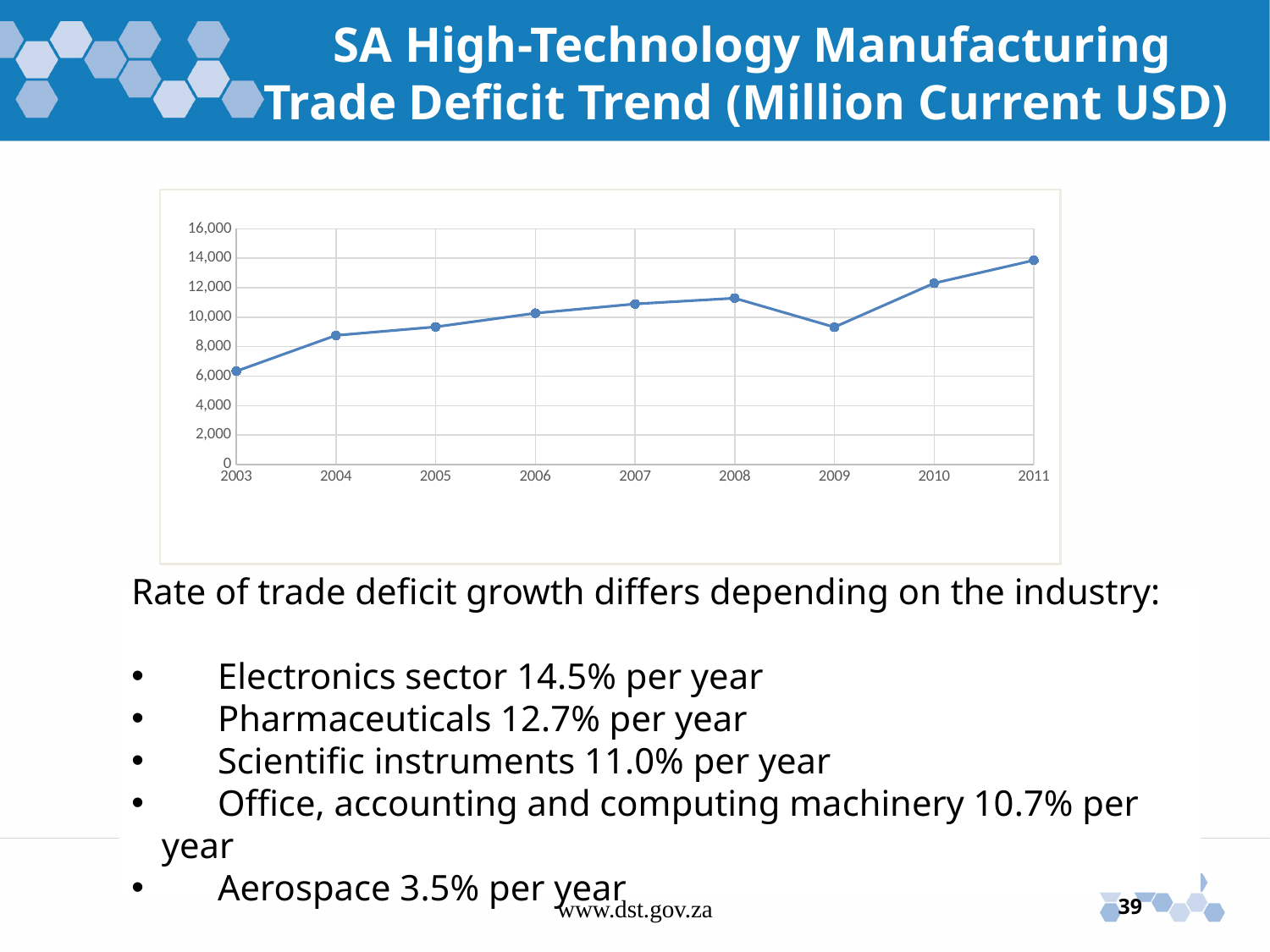
Is the value for 2011 greater or less than 12,000? greater Which year has the larger value, 2008 or 2009? 2008 How many years are plotted on the x axis of the chart? 9 Is the value for 2010 greater or less than 10,000? greater Which year has the highest trade deficit value in the chart? 2011 Is the value for 2009 greater or less than 10,000? less Which year has the lowest trade deficit value in the chart? 2003 What kind of chart is shown on the slide? line chart Does the trade deficit generally rise or fall from 2003 to 2011? rise Which year has the larger value, 2007 or 2010? 2010